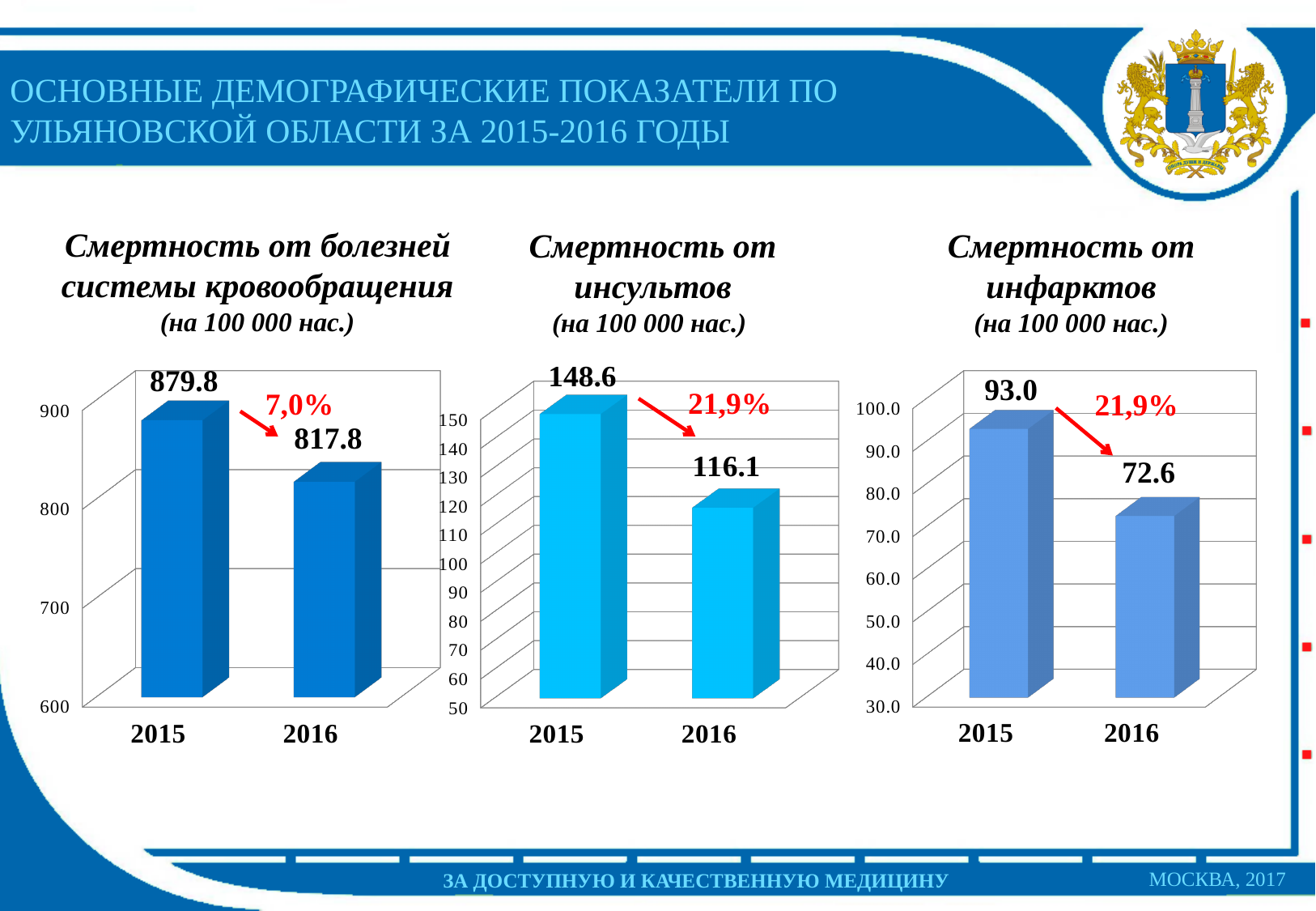
What kind of chart is the chart titled "Смертность от инфарктов"? bar chart In the chart titled "Смертность от болезней системы кровообращения", by how much did the value decrease from 2015 to 2016? 62.0 In the chart titled "Смертность от инсультов", do the values rise or fall from 2015 to 2016? fall In the chart titled "Смертность от инсультов", what is the value for 2016? 116.1 In the chart titled "Смертность от болезней системы кровообращения", what is the value for 2015? 879.8 In the chart titled "Смертность от инфарктов", which year has the highest value? 2015 In the chart titled "Смертность от инсультов", what is the value for 2015? 148.6 In the chart titled "Смертность от инфарктов", what is the value for 2016? 72.6 In the chart titled "Смертность от инфарктов", what is the difference between the 2015 and 2016 values? 20.4 How many years are shown on the x axis of the chart titled "Смертность от болезней системы кровообращения"? 2 In the chart titled "Смертность от инсультов", what is the difference between the 2015 and 2016 values? 32.5 In the chart titled "Смертность от болезней системы кровообращения", what is the value for 2016? 817.8